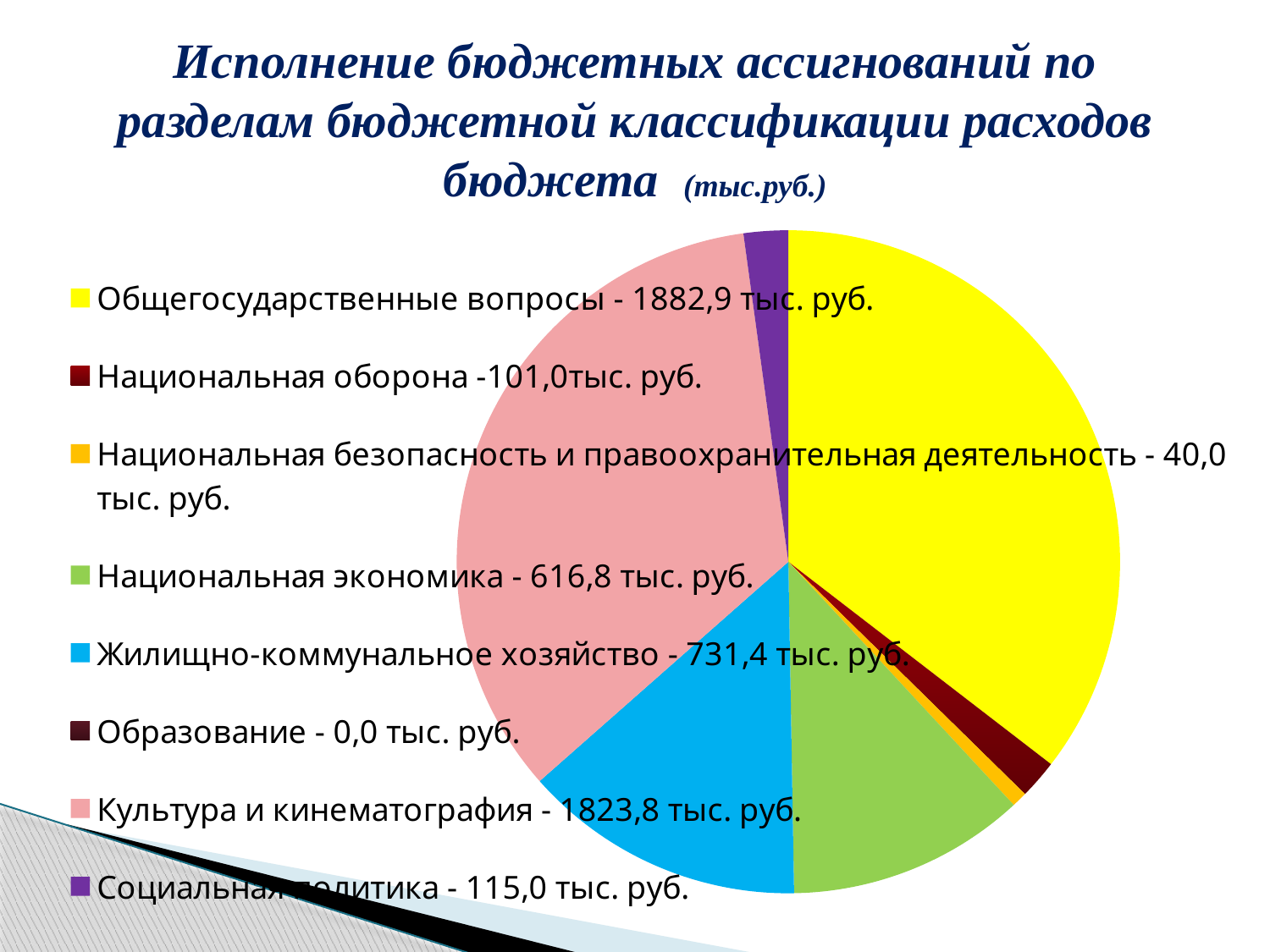
What is the value for Культура и кинематография? 1823,8 тыс. руб. What is the value for Жилищно-коммунальное хозяйство? 731,4 тыс. руб. Which category has the smallest value in the pie chart? Образование Which category has the largest value in the pie chart? Общегосударственные вопросы What colour is the slice for Культура и кинематография? pink What kind of chart is shown on the slide? pie chart What is the value for Национальная безопасность и правоохранительная деятельность? 40,0 тыс. руб. What is the value for Общегосударственные вопросы? 1882,9 тыс. руб. How many categories does the pie chart's legend list? 8 Which is larger, Социальная политика or Национальная оборона? Социальная политика What is the difference between Жилищно-коммунальное хозяйство and Национальная экономика? 114,6 тыс. руб. What is the difference between Общегосударственные вопросы and Культура и кинематография? 59,1 тыс. руб.